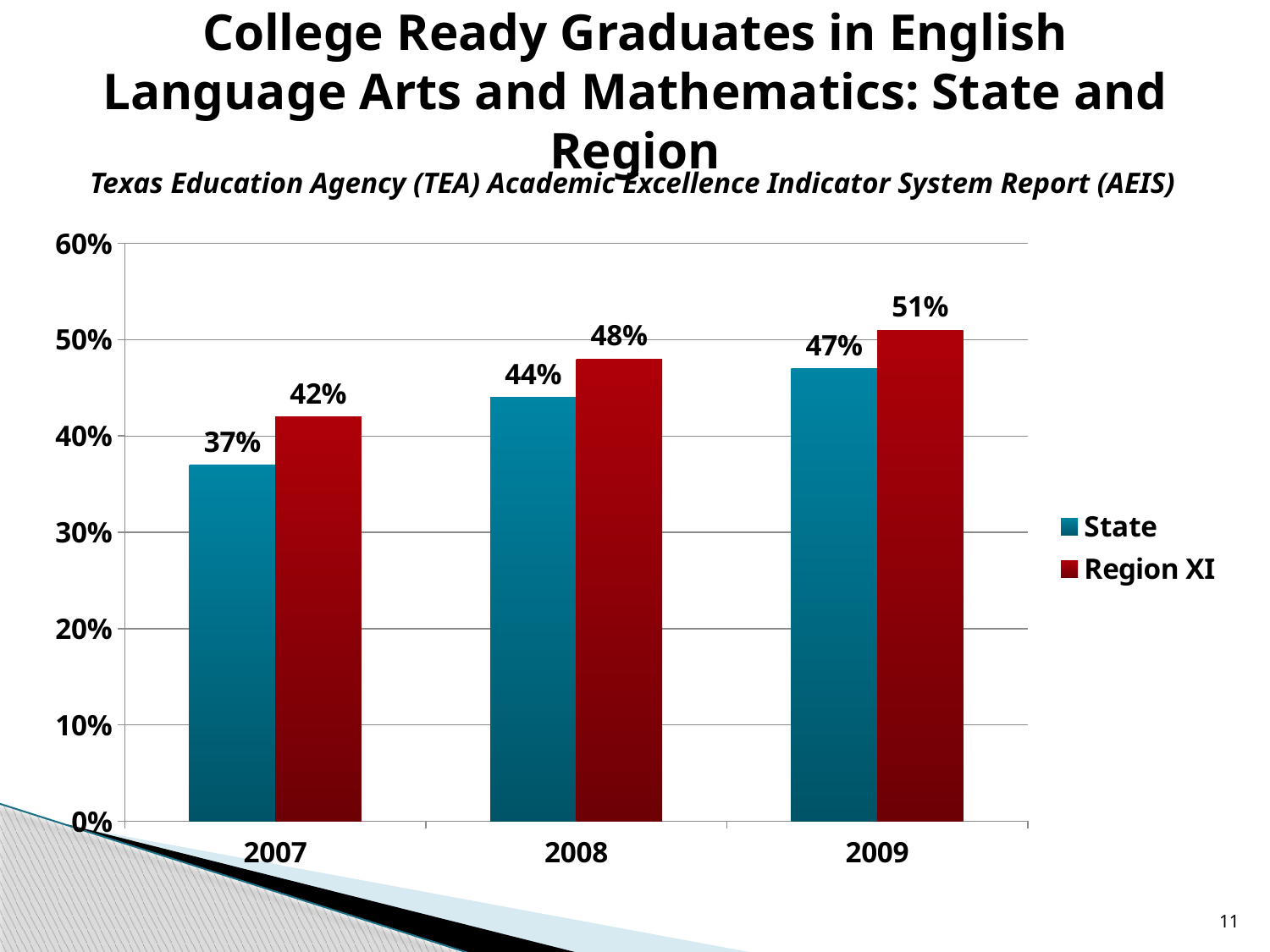
What is the Region XI value for 2008? 48% How many years are shown on the x axis? 3 In which year is the Region XI value lowest? 2007 Do the Region XI values rise or fall from 2007 to 2009? Rise What is the difference between the Region XI and State values in 2008? 4% What kind of chart is shown on the slide? Bar chart What is the Region XI value for 2009? 51% What is the difference between the State values for 2009 and 2007? 10% Which is larger in 2009, the State value or the Region XI value? Region XI How many series does the legend list? 2 What is the State value for 2007? 37% In which year is the State value highest? 2009